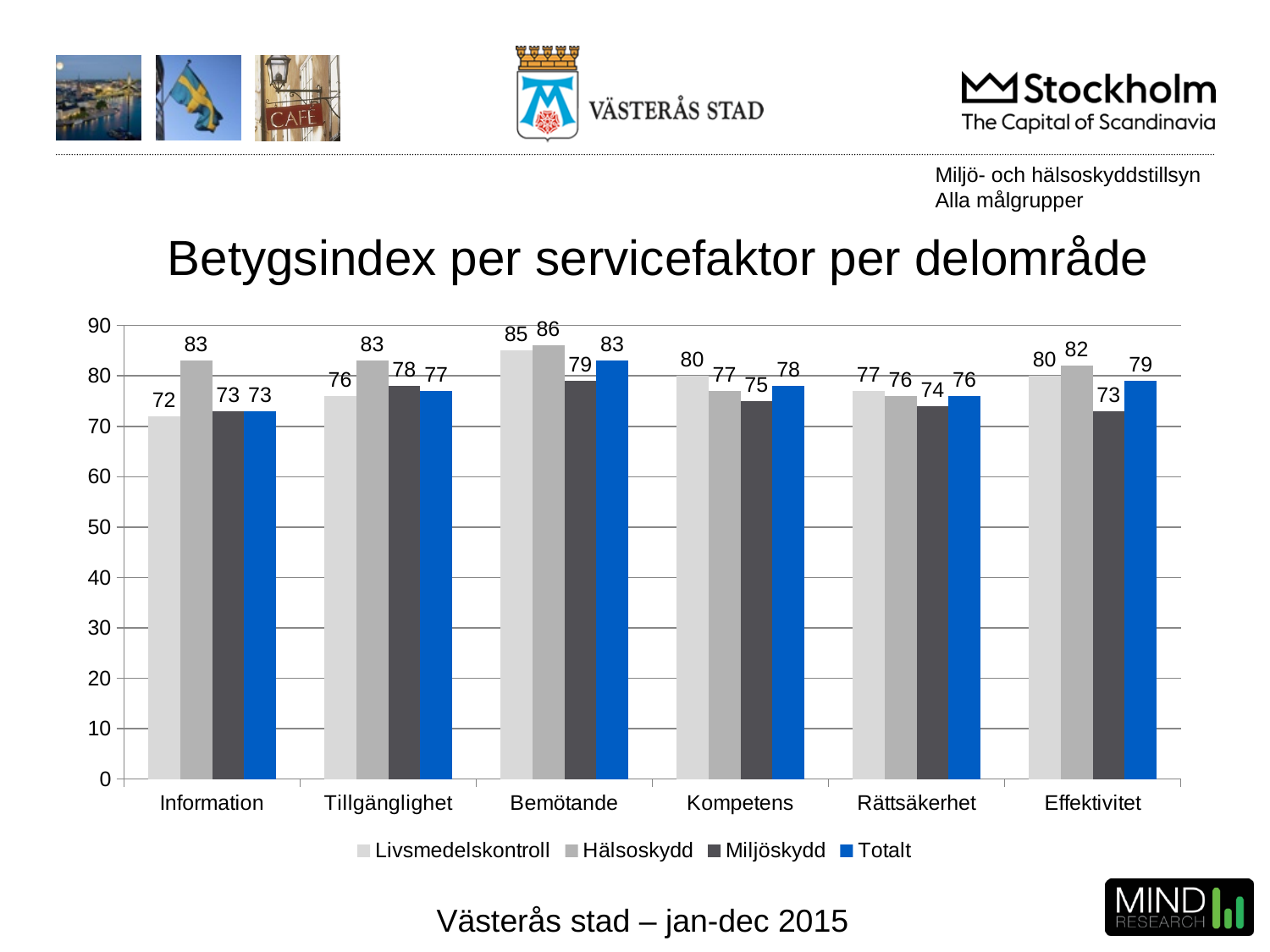
What is the Livsmedelskontroll value for Information? 72 What is the Miljöskydd value for Rättsäkerhet? 74 What is the title of the chart? Betygsindex per servicefaktor per delområde What kind of chart is shown on the slide? bar chart Which is larger for Kompetens: the Livsmedelskontroll value or the Hälsoskydd value? Livsmedelskontroll Which category has the highest Hälsoskydd value? Bemötande What is the Totalt value for Bemötande? 83 Is the Miljöskydd value for Effektivitet greater or less than 80? less How many categories are shown on the x axis? 6 How many series does the legend list? 4 What is the difference between the Hälsoskydd and Livsmedelskontroll values for Information? 11 Which category has the lowest Totalt value? Information